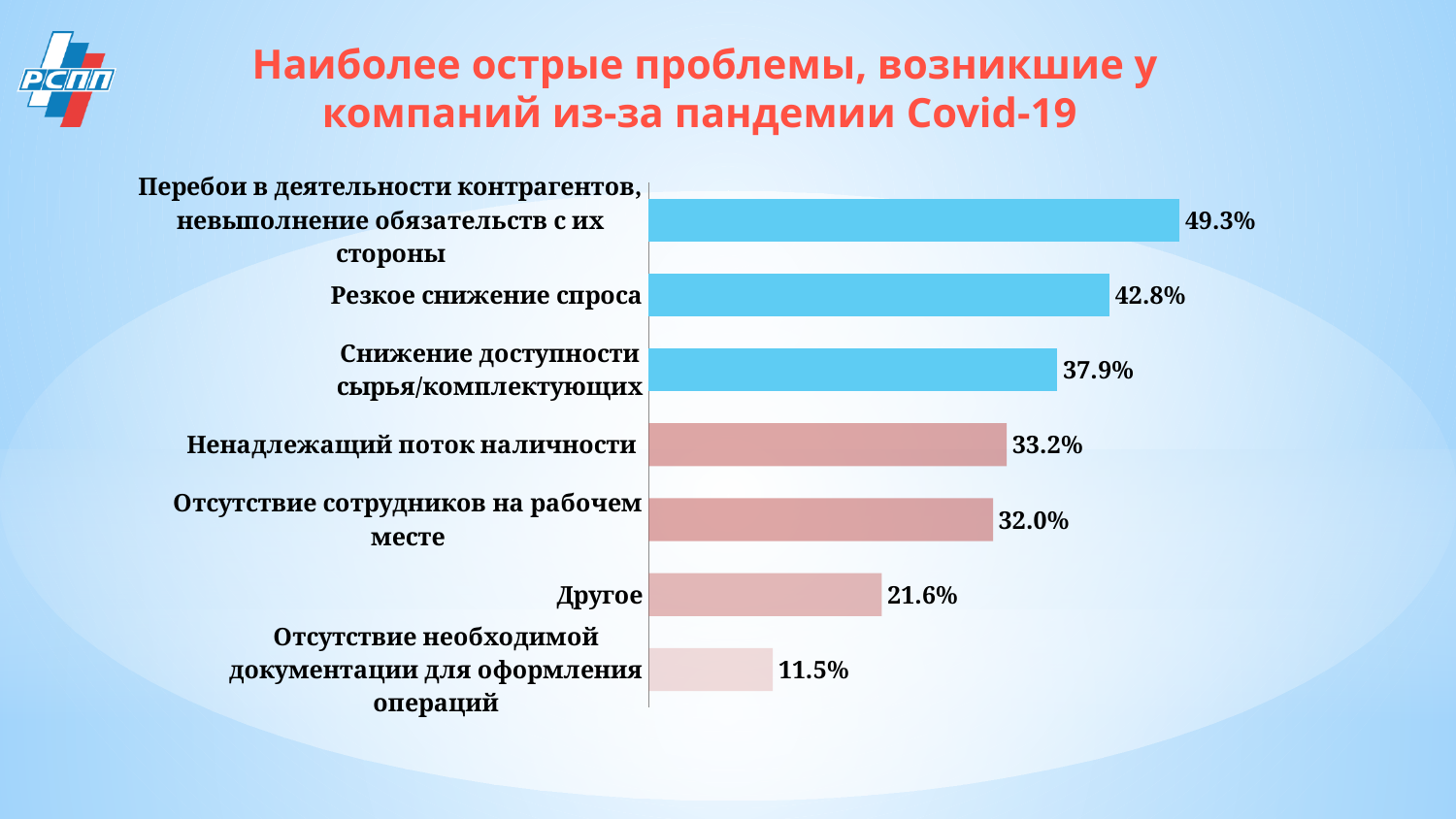
What is the value for «Ненадлежащий поток наличности»? 33.2% How many categories are shown in the chart? 7 What is the title of the slide? Наиболее острые проблемы, возникшие у компаний из-за пандемии Covid-19 What is the difference between the values for «Другое» and «Отсутствие необходимой документации для оформления операций»? 10.1% What is the value for «Другое»? 21.6% What is the difference between the values for «Резкое снижение спроса» and «Снижение доступности сырья/комплектующих»? 4.9% What is the value for «Отсутствие сотрудников на рабочем месте»? 32.0% Which category has the lowest value? Отсутствие необходимой документации для оформления операций Which is larger: the value for «Ненадлежащий поток наличности» or for «Отсутствие сотрудников на рабочем месте»? Ненадлежащий поток наличности Which category has the highest value? Перебои в деятельности контрагентов, невыполнение обязательств с их стороны What kind of chart is shown on the slide? Bar chart What is the value for «Резкое снижение спроса»? 42.8%